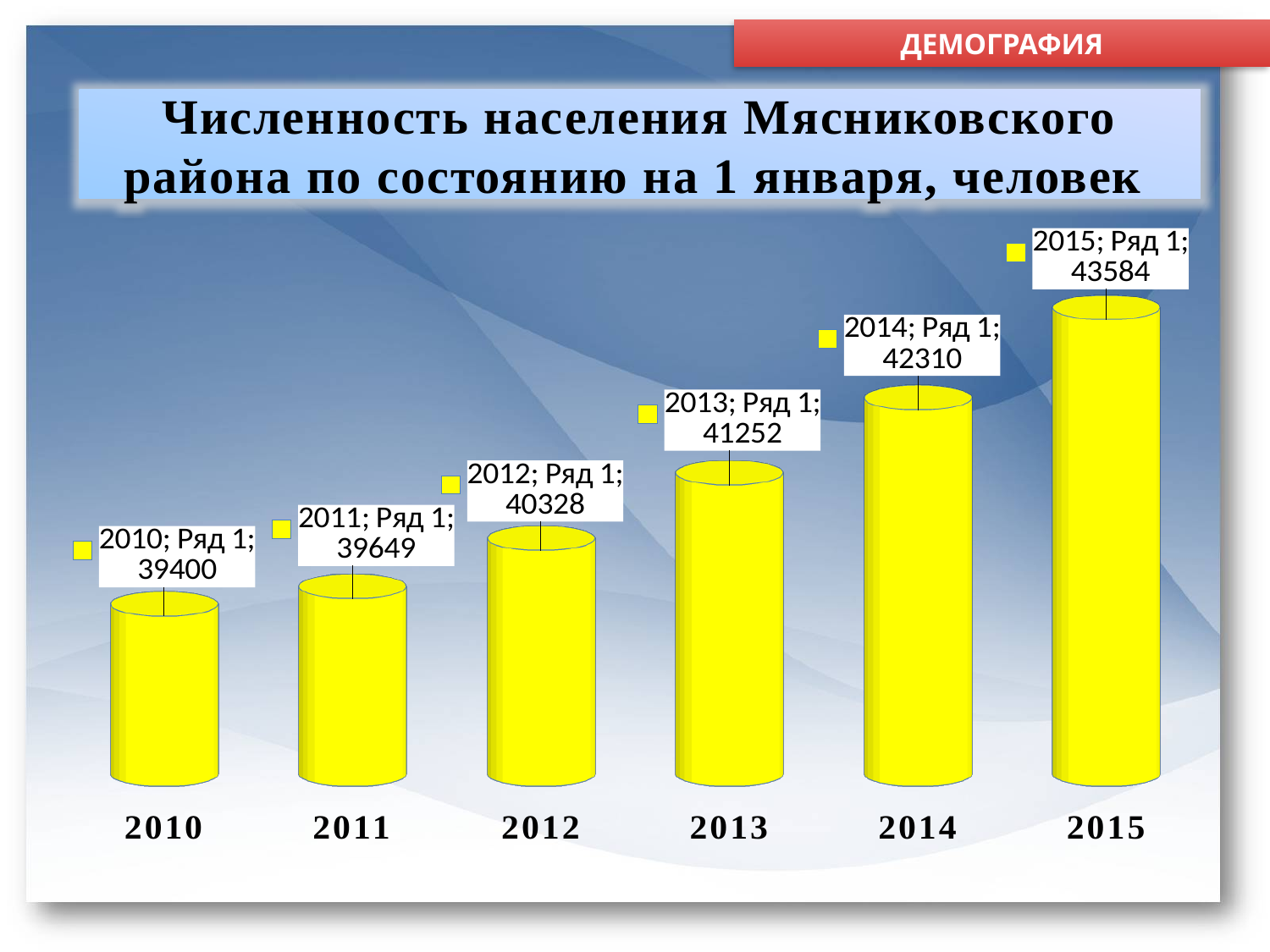
What is the difference between the 2015 and 2010 population values? 4184 Do the values rise or fall from 2010 to 2015? rise What kind of chart is this? bar chart What is the population value shown for 2010? 39400 What is the difference between the 2014 and 2013 population values? 1058 Which is larger, the value for 2012 or the value for 2011? 2012 What is the population value shown for 2015? 43584 How many years are shown on the x axis? 6 What is the title of the chart? Численность населения Мясниковского района по состоянию на 1 января, человек Which year has the lowest population value? 2010 Which year has the highest population value? 2015 What is the population value shown for 2013? 41252